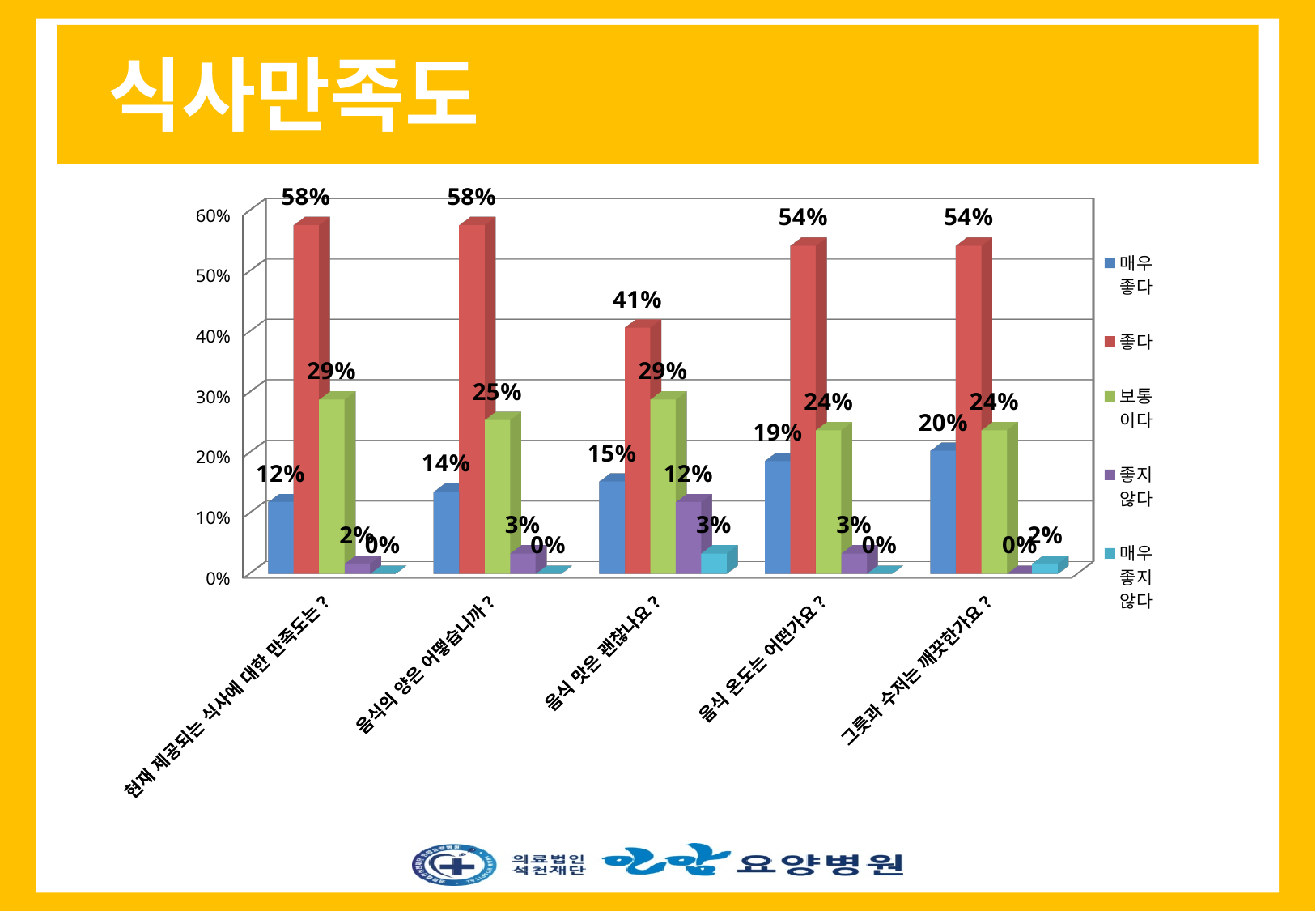
What is the difference between the 좋다 value and the 보통이다 value for 음식 온도는 어떤가요? 30% What is the value of 매우 좋다 for 그릇과 수저는 깨끗한가요? 20% Which category has the highest value for 매우 좋다? 그릇과 수저는 깨끗한가요? How many series does the legend list? 5 Which category has the lowest value for 좋다? 음식 맛은 괜찮나요? What is the value of 보통이다 for 음식의 양은 어떻습니까? 25% How many question categories are shown on the x axis? 5 What kind of chart is shown on the slide? bar chart What is the value of 좋지 않다 for 음식 맛은 괜찮나요? 12% What is the title of the slide? 식사만족도 Which is larger for 음식 맛은 괜찮나요?: 매우 좋다 or 보통이다? 보통이다 What is the value of 좋다 for 현재 제공되는 식사에 대한 만족도는? 58%